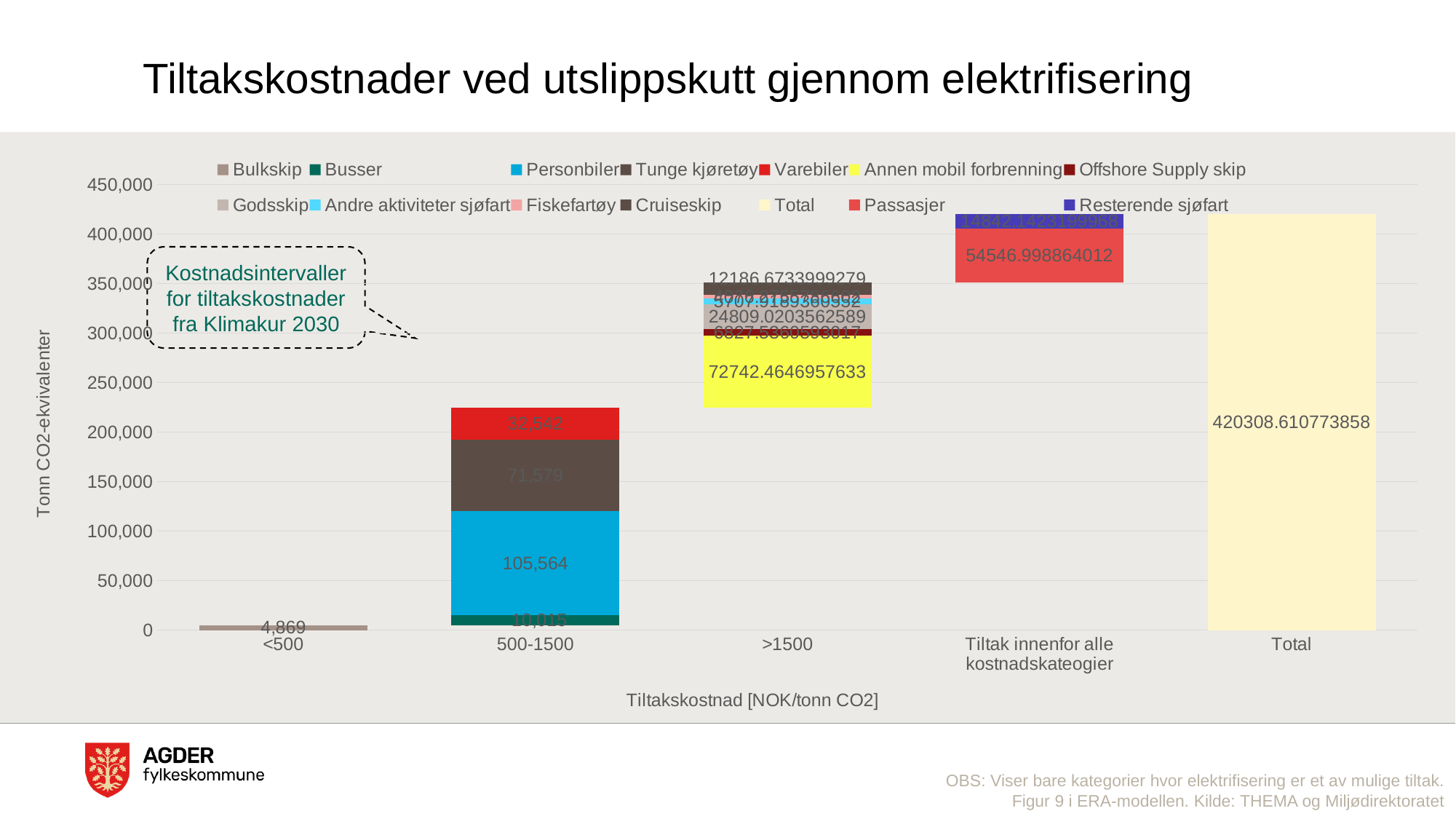
What kind of chart is shown on the slide? Stacked bar chart What is the value for Passasjer in the 'Tiltak innenfor alle kostnadskateogier' category? 54546.998864012 What is the value shown for the Total bar? 420308.610773858 In the 500-1500 category, which is larger: Personbiler or Tunge kjøretøy? Personbiler How many categories are shown on the x axis of the chart? 5 What is the value for Personbiler in the 500-1500 category? 105,564 What is the value for Bulkskip in the <500 category? 4,869 What is the value for Varebiler in the 500-1500 category? 32,542 What is the value for Annen mobil forbrenning in the >1500 category? 72742.4646957633 What is the difference between Personbiler (105,564) and Tunge kjøretøy (71,579) in the 500-1500 category? 33,985 How many series does the chart's legend list? 14